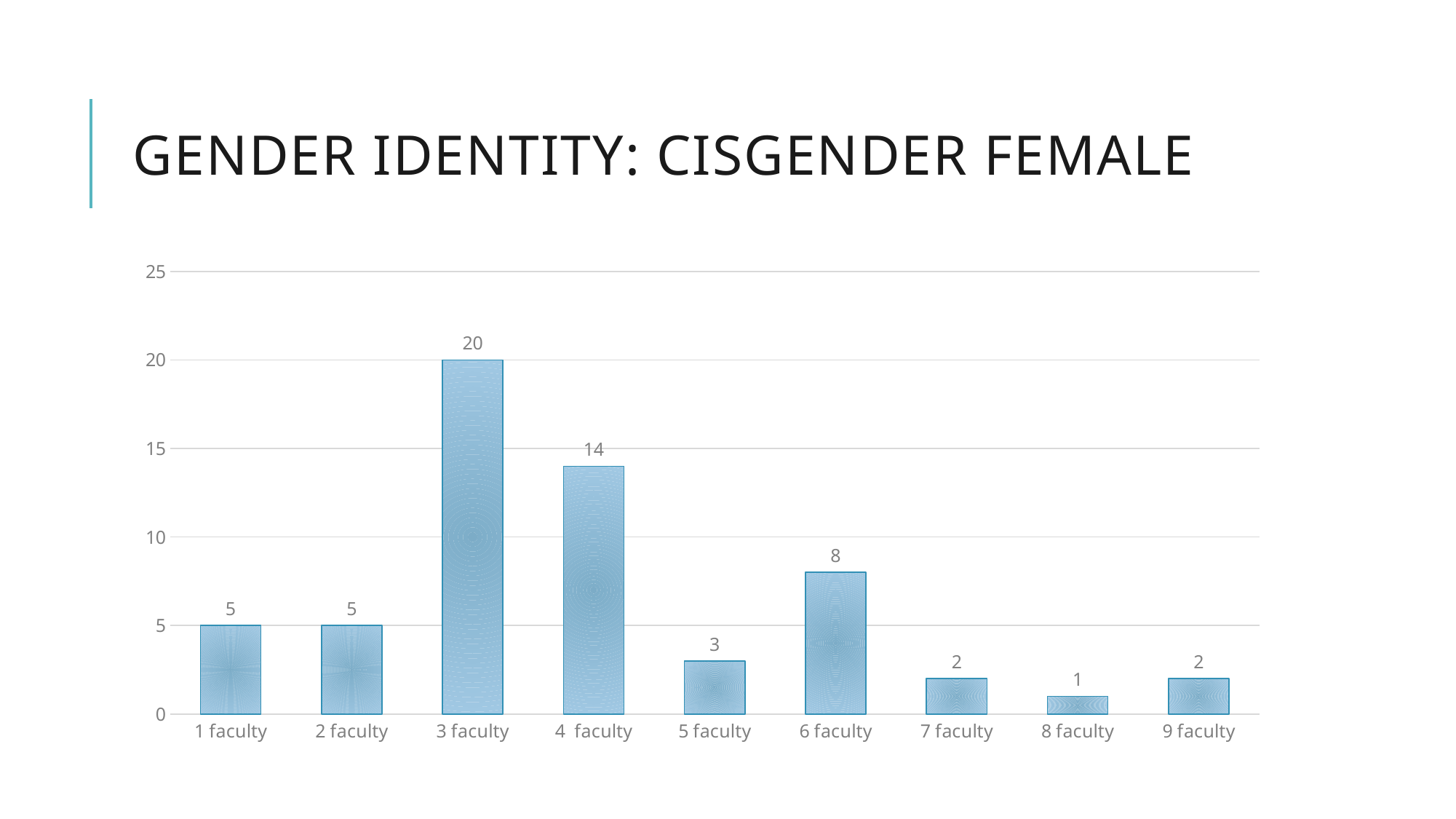
What is the value for 6 faculty? 8 What is the difference between the values for 6 faculty and 7 faculty? 6 What is the value for 8 faculty? 1 What is the title of the slide? GENDER IDENTITY: CISGENDER FEMALE Is the value for 4 faculty greater or less than 10? greater How many categories are shown on the x axis? 9 What is the difference between the values for 3 faculty and 4 faculty? 6 Which is larger, the value for 5 faculty or the value for 6 faculty? 6 faculty Which category has the highest value? 3 faculty What kind of chart is shown on the slide? bar chart Which category has the lowest value? 8 faculty What is the value for 3 faculty? 20